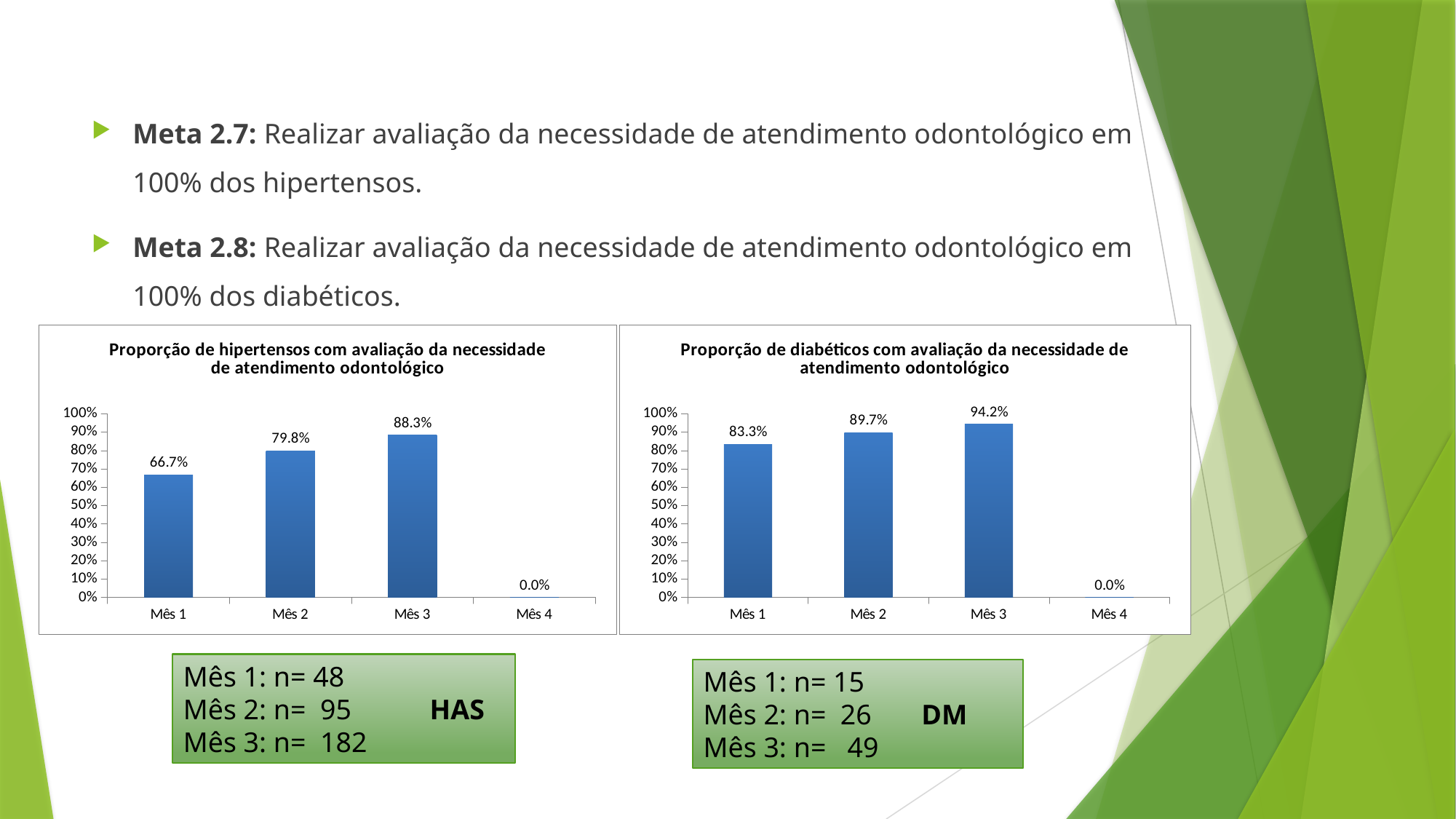
In the left chart (Proporção de hipertensos com avaliação da necessidade de atendimento odontológico), what is the value for Mês 2? 79.8% In the right chart (diabéticos), do the values rise or fall from Mês 1 to Mês 3? Rise What kind of chart is the left chart (hipertensos)? Bar chart In the right chart (Proporção de diabéticos com avaliação da necessidade de atendimento odontológico), what is the value for Mês 3? 94.2% How many months (categories) are shown on the x axis of the right chart (diabéticos)? 4 In the right chart (diabéticos), what is the difference between the values for Mês 2 and Mês 1? 6.4% In the left chart (hipertensos), what is the difference between the values for Mês 3 and Mês 1? 21.6% In the right chart (diabéticos), which month has the lowest value? Mês 4 In the left chart (hipertensos), is the value for Mês 2 greater or less than 70%? greater What is the title of the right chart? Proporção de diabéticos com avaliação da necessidade de atendimento odontológico Which is larger: the value for Mês 1 in the left chart (hipertensos) or the value for Mês 1 in the right chart (diabéticos)? Mês 1 in the right chart (diabéticos) In the left chart (hipertensos), which month has the highest value? Mês 3